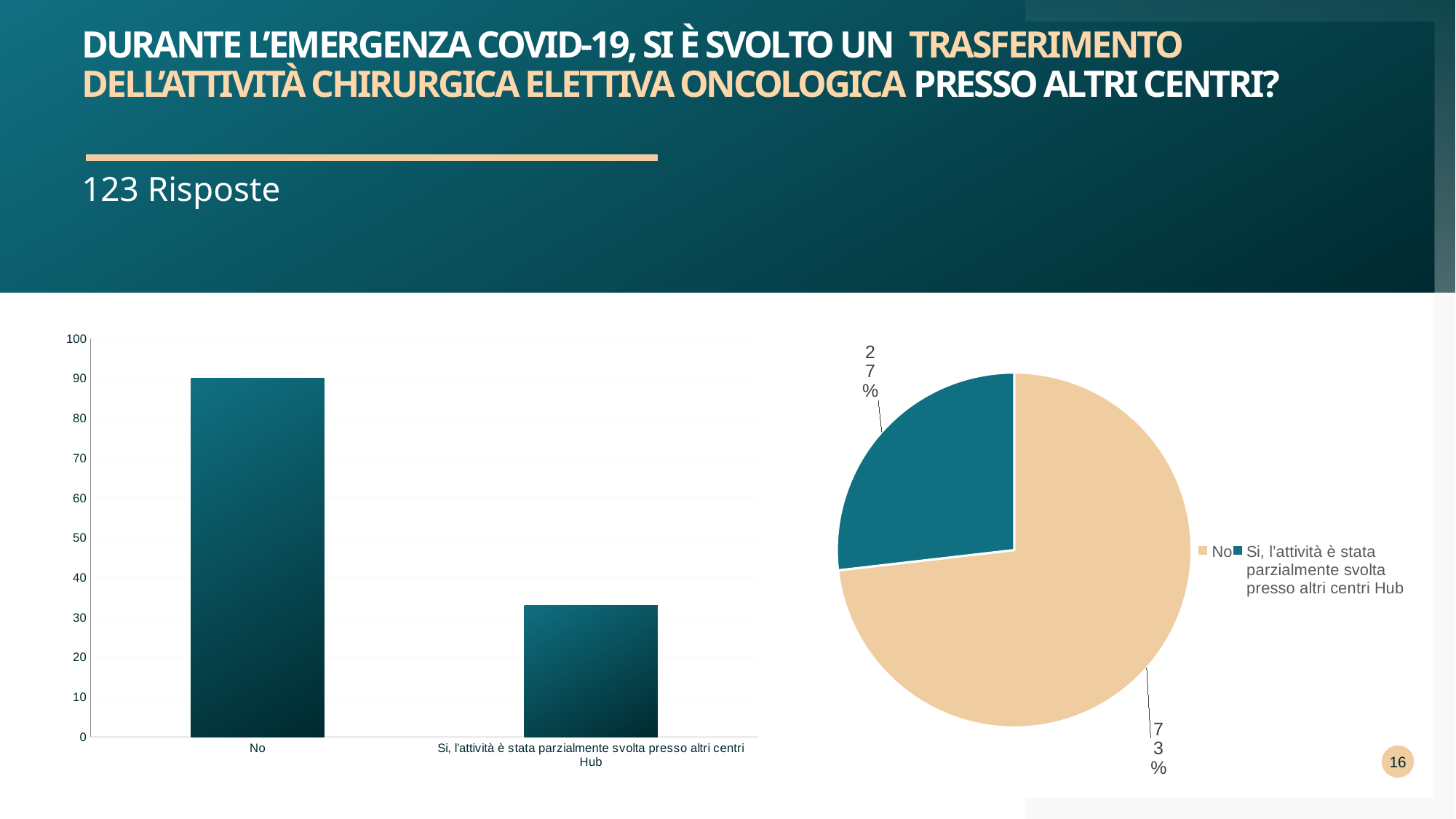
In the bar chart on the left, which category has the highest value? No In the bar chart on the left, how many categories are shown? 2 What kind of chart is the chart on the right of the slide? pie chart What kind of chart is the chart on the left of the slide? bar chart In the bar chart on the left, what is the value for "No"? 90 In the bar chart on the left, is the value for "Si, l'attività è stata parzialmente svolta presso altri centri Hub" greater or less than 30? greater In the pie chart on the right, what share of the pie does the "Si, l'attività è stata parzialmente svolta presso altri centri Hub" slice represent? 27% In the pie chart on the right, what share of the pie does the "No" slice represent? 73% In the pie chart on the right, how many entries does the legend list? 2 In the bar chart on the left, which category has the lowest value? Si, l'attività è stata parzialmente svolta presso altri centri Hub In the bar chart on the left, is the value for "Si, l'attività è stata parzialmente svolta presso altri centri Hub" greater or less than 40? less In the bar chart on the left, which is larger: the value for "No" or the value for "Si, l'attività è stata parzialmente svolta presso altri centri Hub"? No